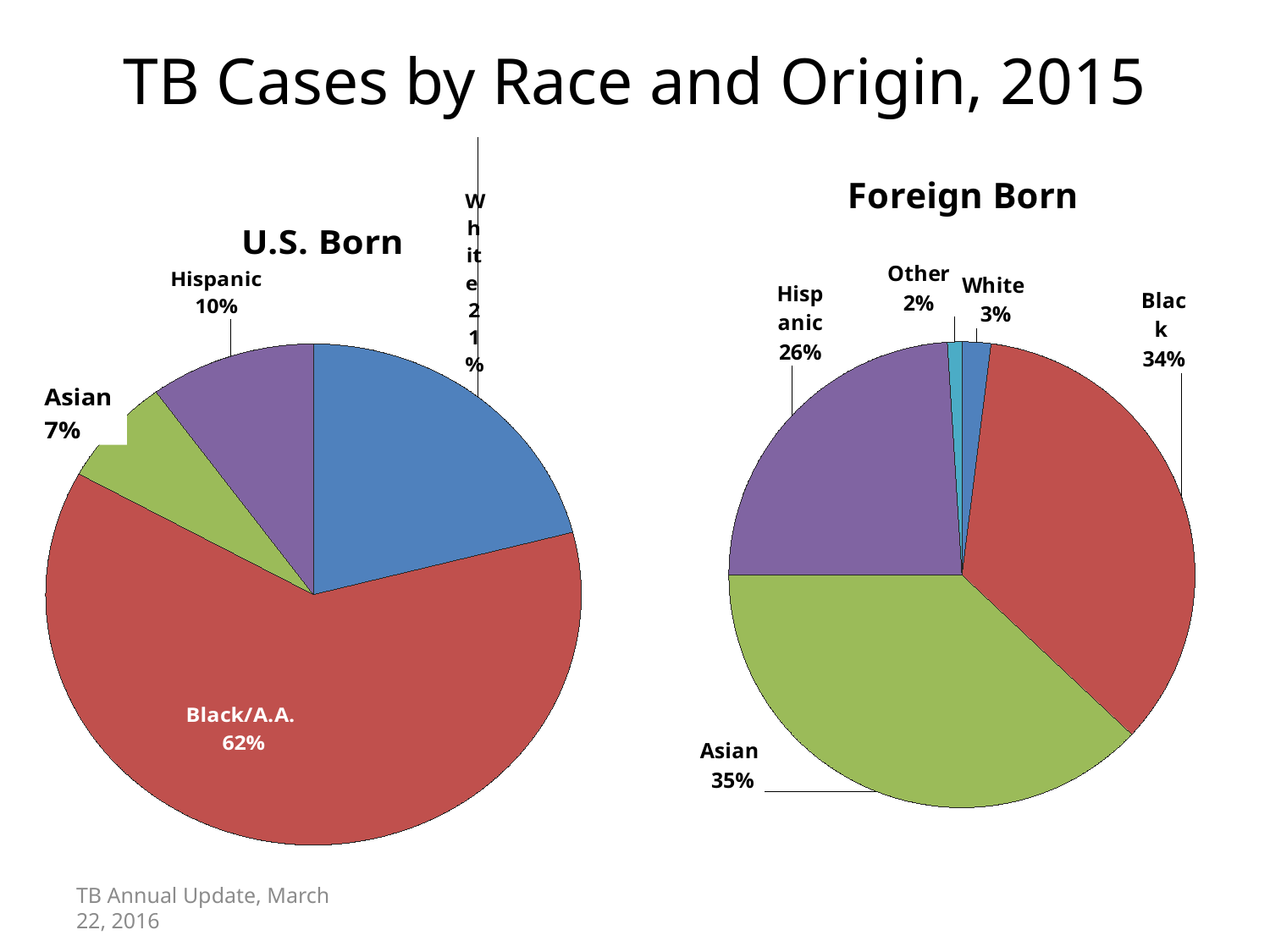
In the Foreign Born pie chart, what is the difference in percentage points between the Black and White shares? 31 In the U.S. Born pie chart, which is larger, the Hispanic share or the Asian share? Hispanic In the Foreign Born pie chart, what share of TB cases is Asian? 35% In the U.S. Born pie chart, which category has the smallest share? Asian How many categories are shown in the Foreign Born pie chart? 5 In the U.S. Born pie chart, what share of TB cases is Black/A.A.? 62% In the U.S. Born pie chart, which category has the largest share? Black/A.A. In the U.S. Born pie chart, what percentage is labelled for Hispanic? 10% In the Foreign Born pie chart, what percentage is labelled for Hispanic? 26% In the U.S. Born pie chart, what percentage is labelled for White? 21% What type of chart is used for the U.S. Born data? Pie chart In the Foreign Born pie chart, which category has the smallest share? Other